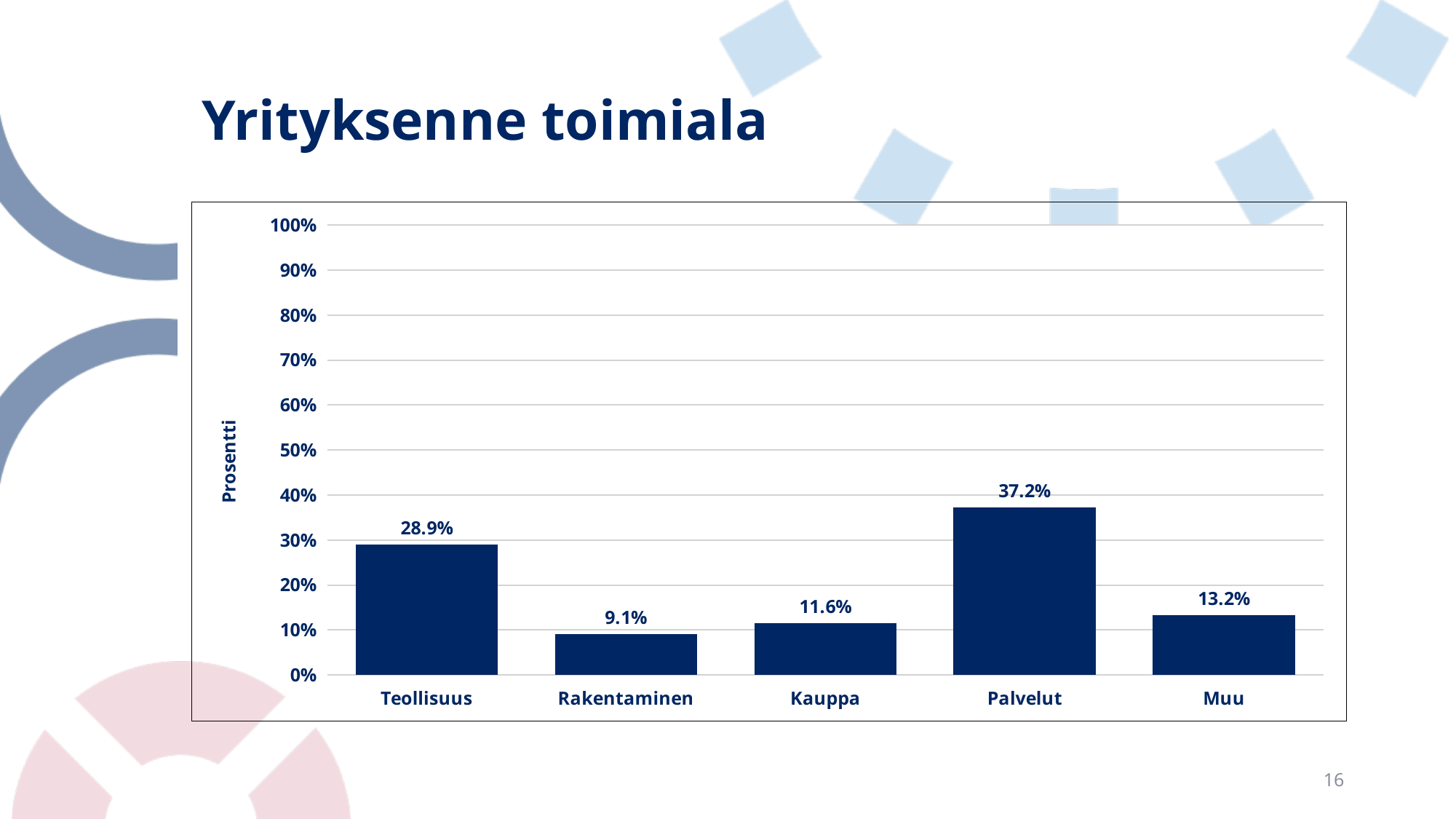
What kind of chart is shown on the slide? Bar chart Which category has the lowest value? Rakentaminen Which category has the highest value? Palvelut Which is larger, the value for Kauppa or the value for Muu? Muu How many categories are shown on the x axis? 5 What is the value for Teollisuus? 28.9% What is the value for Kauppa? 11.6% What is the difference between the values for Palvelut and Teollisuus? 8.3% What is the value for Muu? 13.2% What is the value for Rakentaminen? 9.1% What is the value for Palvelut? 37.2% What is the title of the slide containing the chart? Yrityksenne toimiala